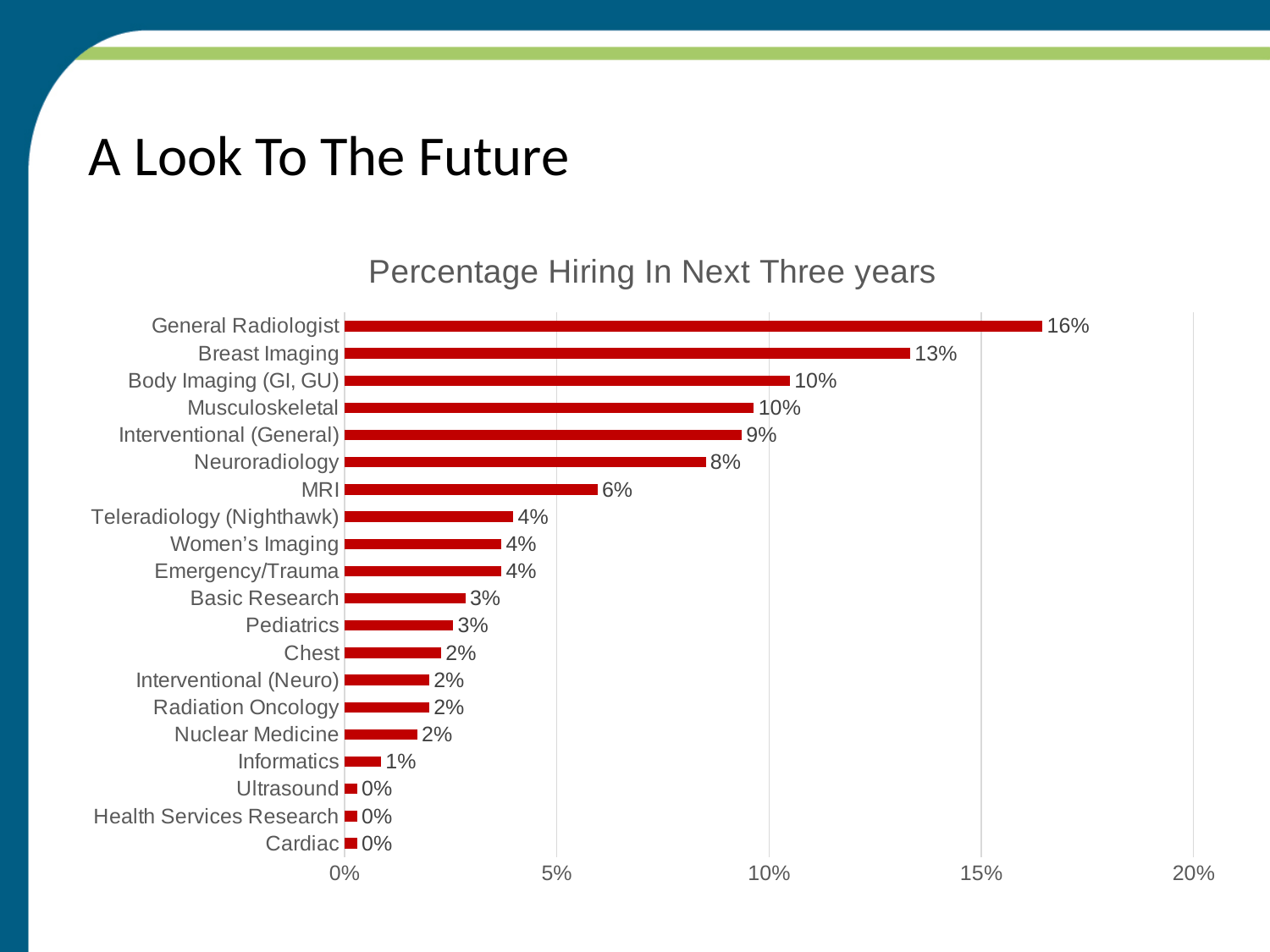
How many categories are shown in the chart? 20 What is the value for General Radiologist? 16% What is the difference between the values for General Radiologist and Breast Imaging? 3% What is the value for Breast Imaging? 13% Is the value for Breast Imaging greater or less than 10%? greater What is the value for Neuroradiology? 8% What is the title of the chart? Percentage Hiring In Next Three years What is the difference between the values for MRI and Teleradiology (Nighthawk)? 2% What kind of chart is shown on the slide? Bar chart Which category has the highest percentage hiring in the next three years? General Radiologist Which is larger, the value for Interventional (General) or the value for MRI? Interventional (General) What is the value for Informatics? 1%